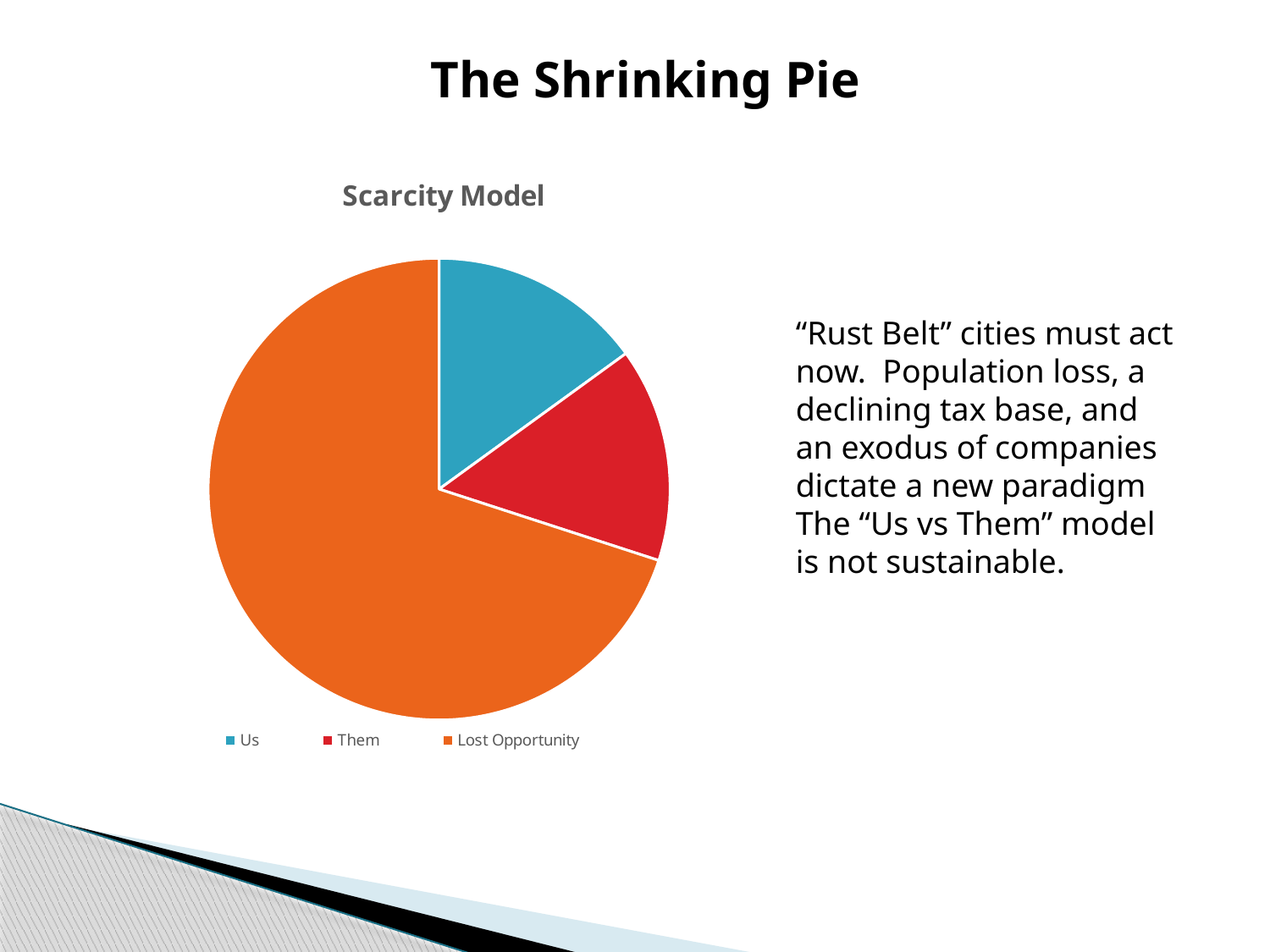
What is the title of the pie chart on the slide? Scarcity Model Which category has the largest slice in the Scarcity Model pie chart? Lost Opportunity In the Scarcity Model pie chart, which slice is larger: Lost Opportunity or Us? Lost Opportunity How many slices does the Scarcity Model pie chart have? 3 What colour is the Lost Opportunity slice in the Scarcity Model pie chart? orange How many entries does the legend of the Scarcity Model chart list? 3 In the Scarcity Model pie chart, which slice is larger: Them or Lost Opportunity? Lost Opportunity What kind of chart is shown under the title "Scarcity Model"? pie chart